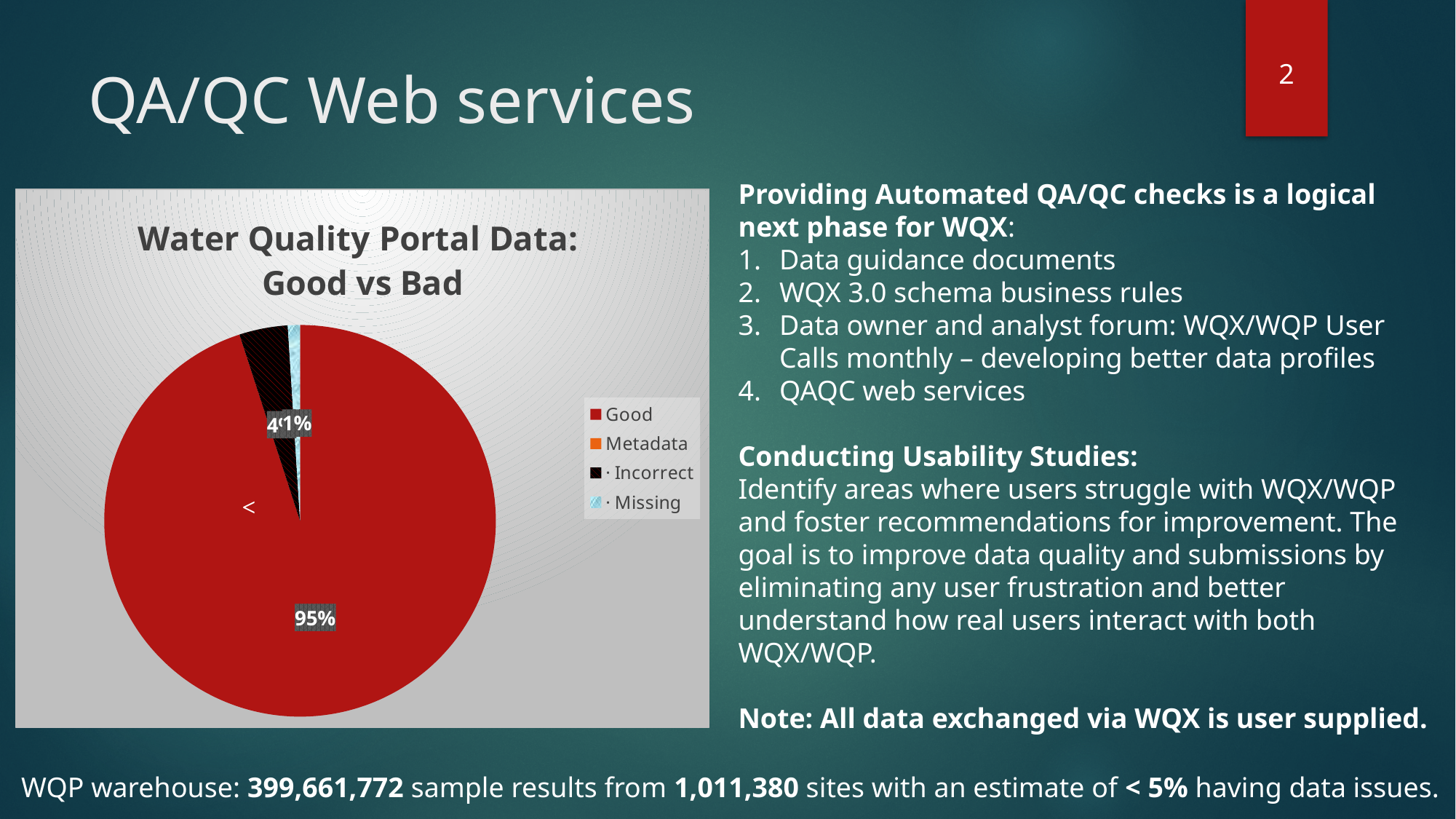
What percentage of the pie is labelled for the Good category? 95% What share of the pie does the Good slice take up? 95% What kind of chart is shown on the slide? pie chart What is the title of the chart? Water Quality Portal Data: Good vs Bad Which legend entry is listed second in the chart's legend? Metadata Which is larger, the Good slice or the Missing slice? Good Which is larger, the Good slice or the Incorrect slice? Good How many entries does the chart's legend list? 4 What colour is used for the Good category in the pie chart? red Which category has the largest slice of the pie? Good